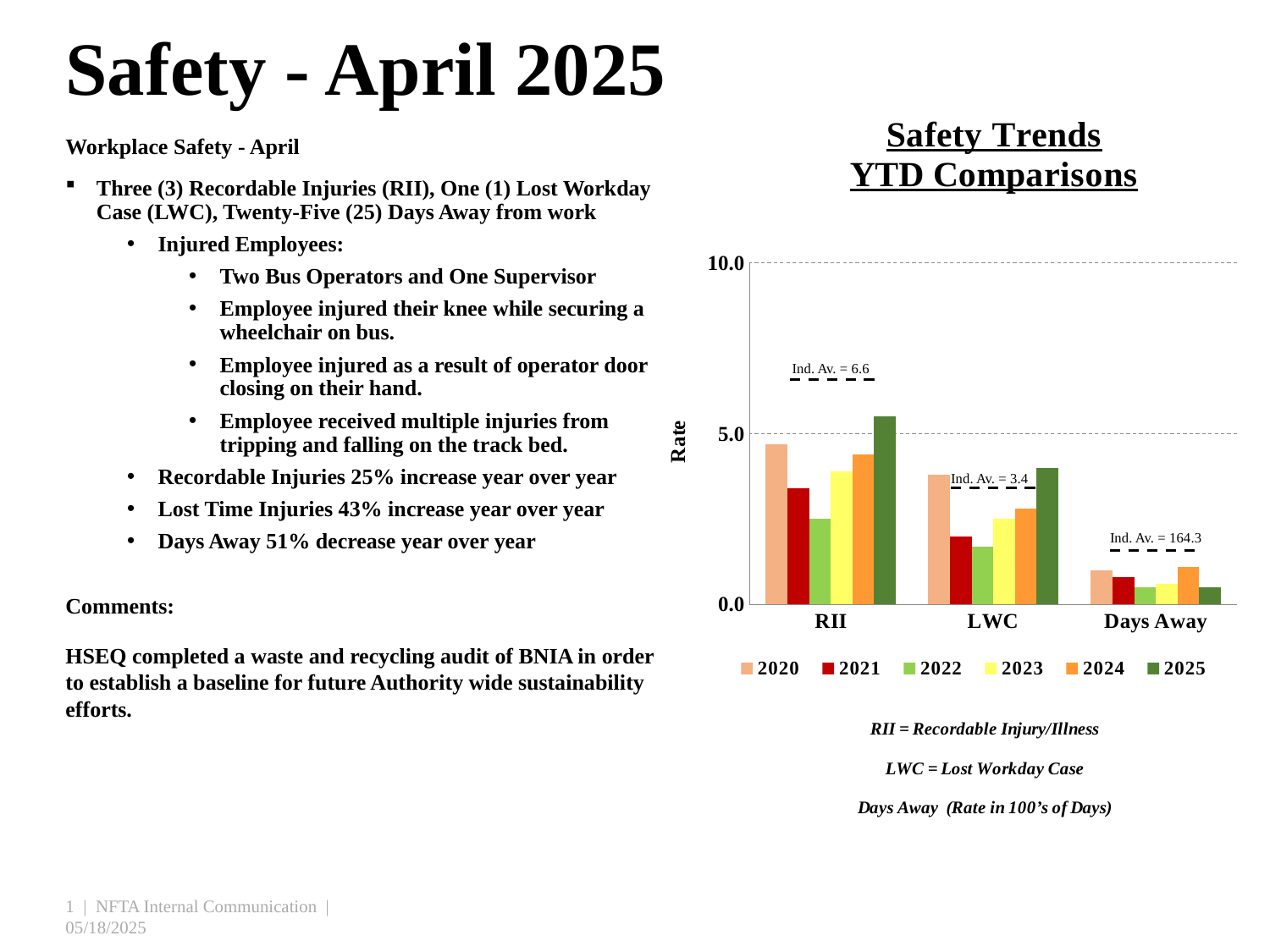
How many categories are shown on the x axis of the Safety Trends chart? 3 How many series does the legend of the Safety Trends chart list? 6 In the Safety Trends chart, is the RII value for 2025 greater or less than 5.0? greater In the Safety Trends chart, which year has the highest bar in the RII category? 2025 What kind of chart is shown under the title "Safety Trends YTD Comparisons"? bar chart In the Safety Trends chart, is the RII value for 2022 greater or less than 5.0? less In the Safety Trends chart, what industry average is annotated for the RII category? 6.6 In the Safety Trends chart, which is larger: the RII value for 2020 or the RII value for 2021? 2020 In the Safety Trends chart, which year has the lowest bar in the RII category? 2022 In the Safety Trends chart, what industry average is annotated for the Days Away category? 164.3 In the Safety Trends chart, is the LWC value for 2020 greater or less than 5.0? less In the Safety Trends chart, which year has the lowest bar in the LWC category? 2022